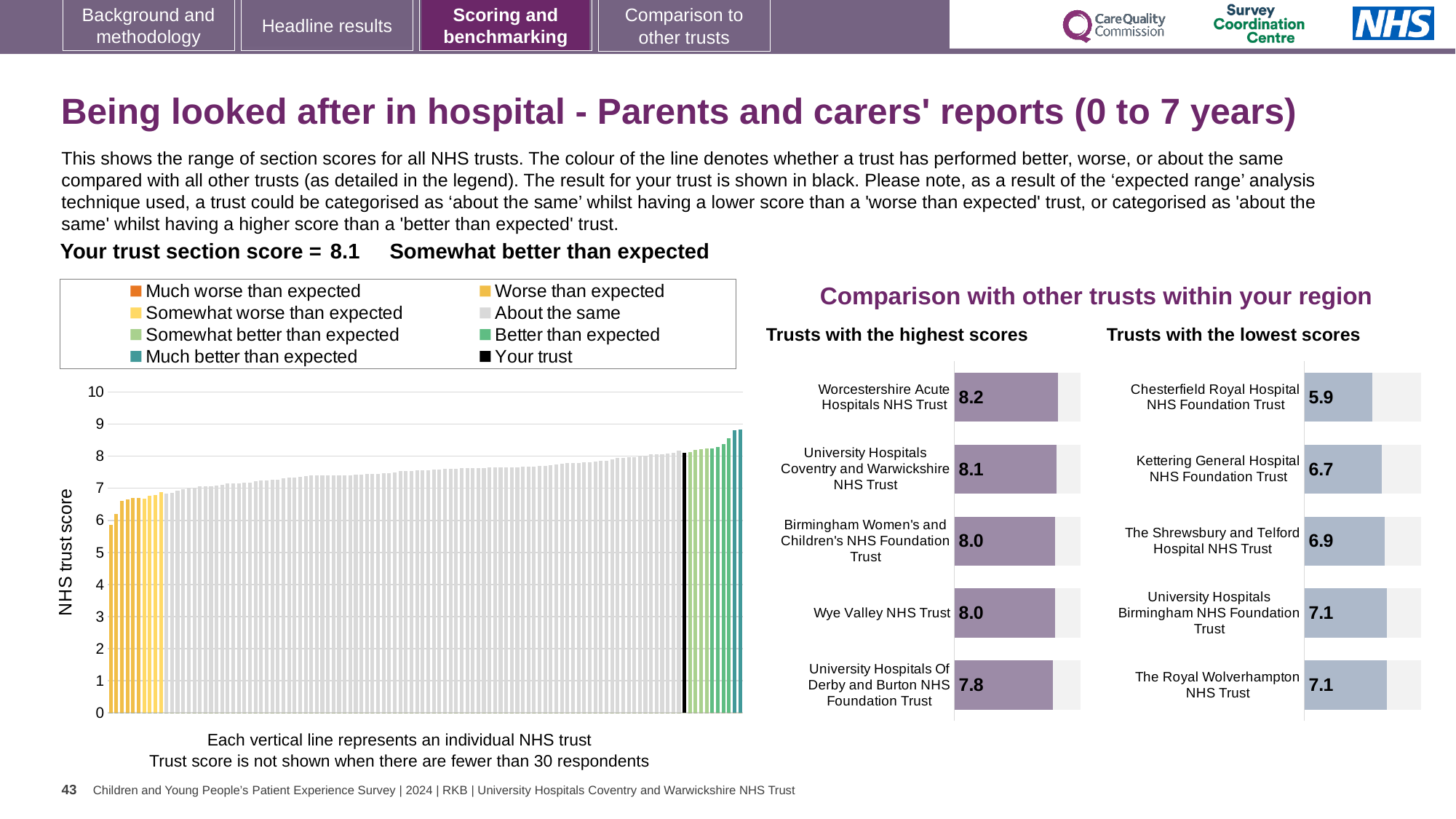
In the 'Trusts with the highest scores' chart, what is the score for Worcestershire Acute Hospitals NHS Trust? 8.2 In the main NHS trust score chart on the left, do the bar values rise or fall from left to right? rise In the 'Trusts with the lowest scores' chart, which trust has the lowest score? Chesterfield Royal Hospital NHS Foundation Trust In the 'Trusts with the highest scores' chart, which trust has the lowest score shown? University Hospitals Of Derby and Burton NHS Foundation Trust How many trusts are listed in the 'Trusts with the lowest scores' chart? 5 In the 'Trusts with the lowest scores' chart, what is the score for Kettering General Hospital NHS Foundation Trust? 6.7 In the 'Trusts with the lowest scores' chart, which has the larger score: Kettering General Hospital NHS Foundation Trust or The Shrewsbury and Telford Hospital NHS Trust? The Shrewsbury and Telford Hospital NHS Trust In the main NHS trust score chart on the left, is the value of the tallest bar greater or less than 8? greater In the 'Trusts with the highest scores' chart, what is the difference between the scores of Worcestershire Acute Hospitals NHS Trust and University Hospitals Of Derby and Burton NHS Foundation Trust? 0.4 How many entries does the legend above the main NHS trust score chart list? 8 What kind of chart is the main NHS trust score chart on the left? bar chart In the main NHS trust score chart on the left, what is the section score for your trust (the black bar)? 8.1